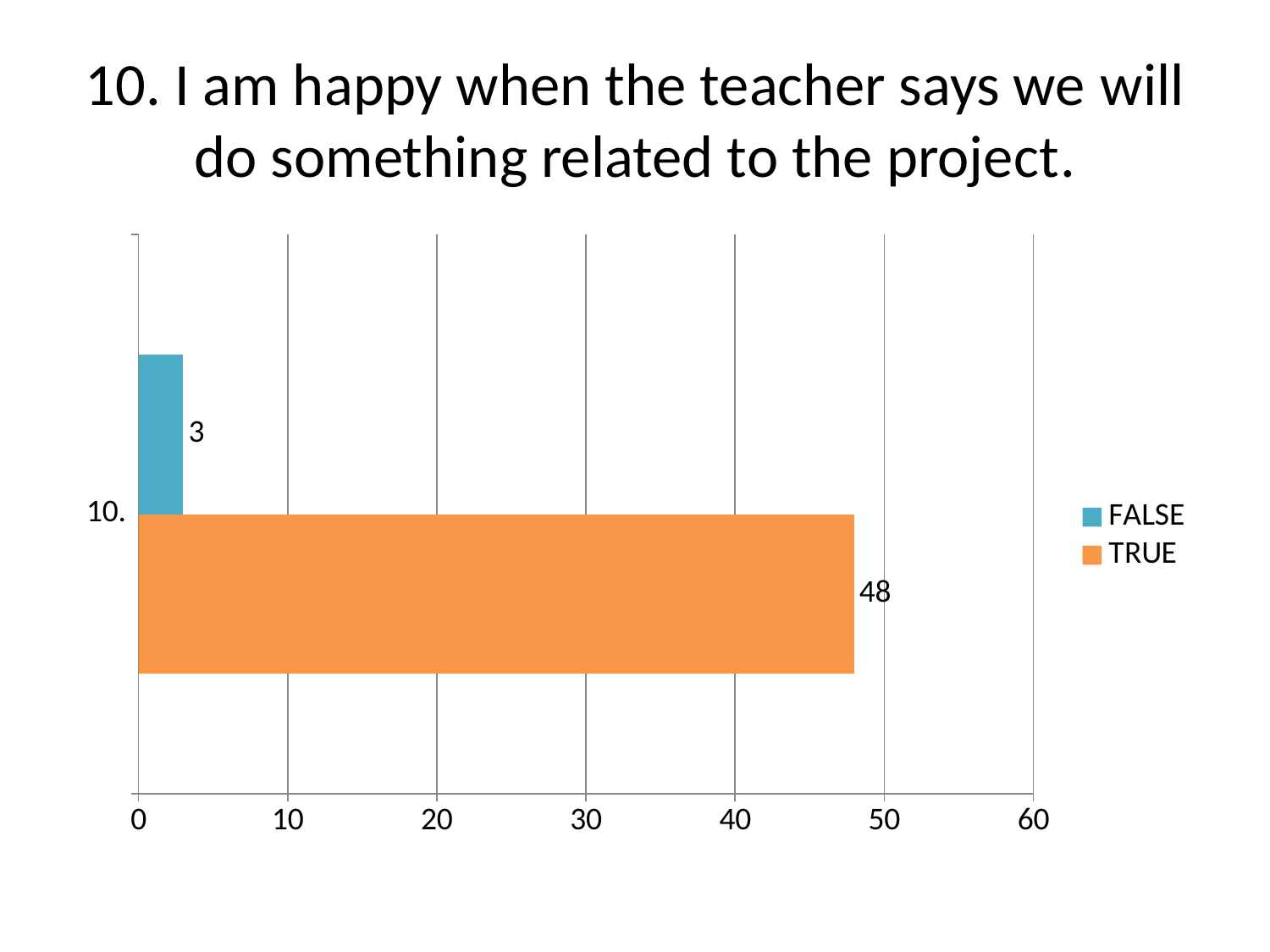
Which series has the higher value, TRUE or FALSE? TRUE Is the value for TRUE greater or less than 40? greater What is the value for TRUE? 48 Is the value for FALSE greater or less than 10? less What colour is the TRUE series? orange What is the difference between the TRUE and FALSE values? 45 What is the value for FALSE? 3 What is the highest value shown on the x axis? 60 What is the total of the TRUE and FALSE values? 51 What kind of chart is shown on the slide? bar chart How many series does the legend list? 2 Which series has the lowest value? FALSE